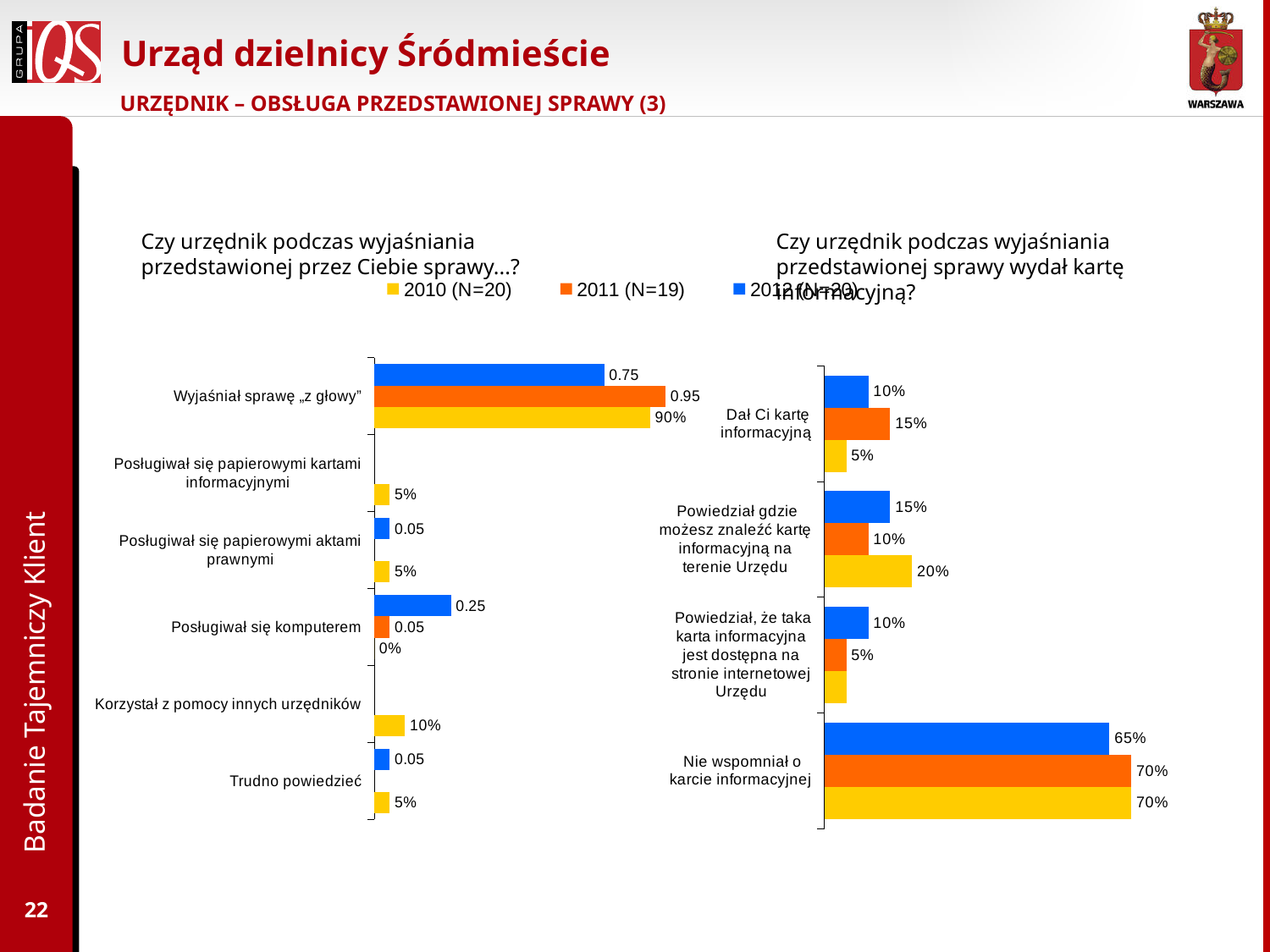
In the right chart, what is the difference between the 2011 (N=19) and 2010 (N=20) values for "Dał Ci kartę informacyjną"? 10 percentage points In the right chart ("Czy urzędnik podczas wyjaśniania przedstawionej sprawy wydał kartę informacyjną?"), what is the 2011 (N=19) value for "Nie wspomniał o karcie informacyjnej"? 70% In the right chart, which category has the highest 2011 (N=19) value? Nie wspomniał o karcie informacyjnej In the left chart ("Czy urzędnik podczas wyjaśniania przedstawionej przez Ciebie sprawy...?"), what is the 2011 (N=19) value for "Wyjaśniał sprawę „z głowy""? 0.95 What kind of chart is the left chart? Bar chart How many series does the legend list? 3 How many categories are shown in the right chart? 4 In the left chart, what is the 2010 (N=20) value for "Korzystał z pomocy innych urzędników"? 10% In the left chart, what is the value of the blue series for "Posługiwał się komputerem"? 0.25 In the right chart, for "Dał Ci kartę informacyjną", which is larger: the 2011 (N=19) value or the 2010 (N=20) value? 2011 (N=19) In the right chart, what is the 2010 (N=20) value for "Powiedział gdzie możesz znaleźć kartę informacyjną na terenie Urzędu"? 20% How many categories are shown in the left chart? 6